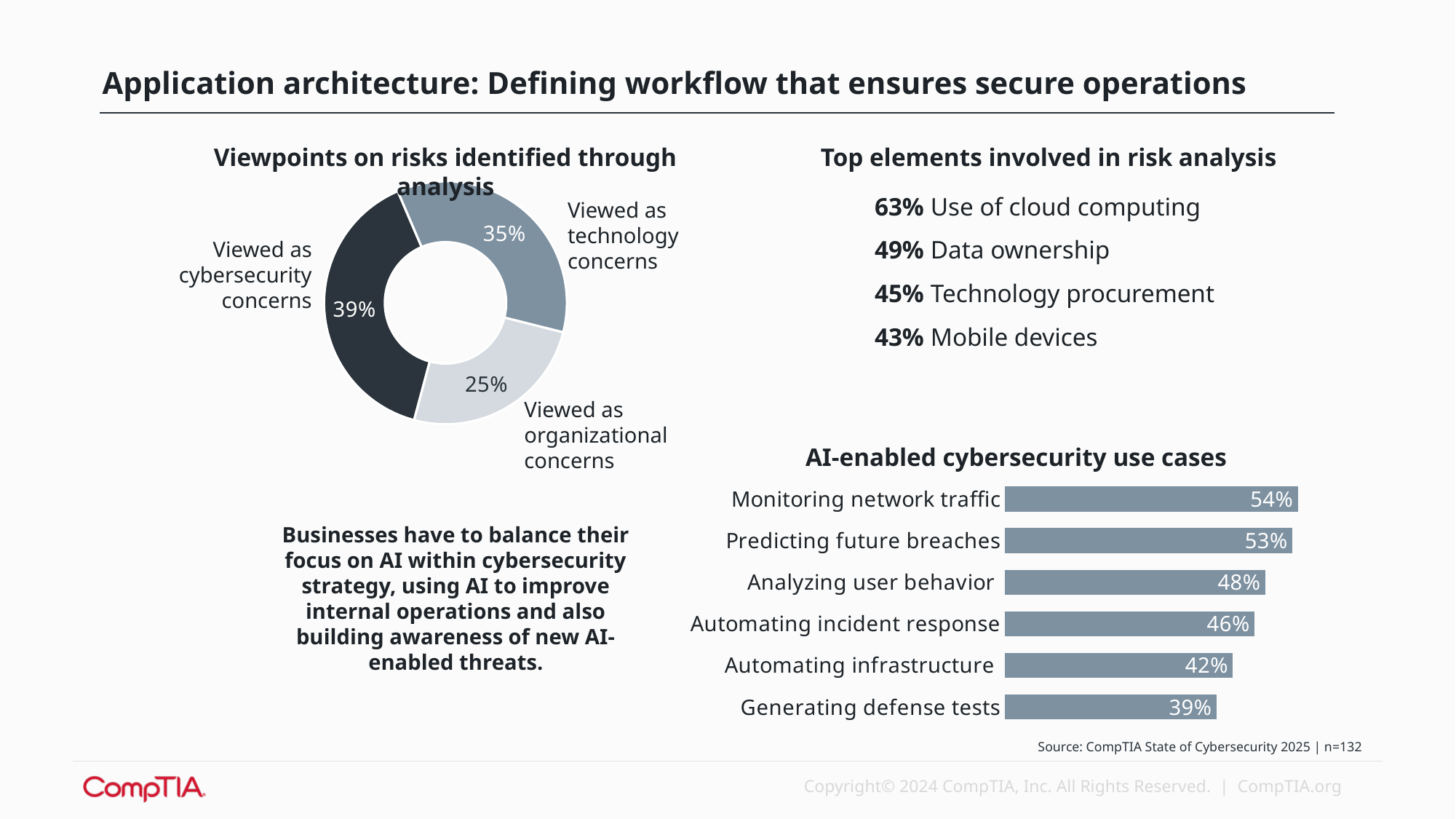
In the 'AI-enabled cybersecurity use cases' chart, which use case has the highest value? Monitoring network traffic In the 'Viewpoints on risks identified through analysis' chart, which viewpoint has the smallest share? Viewed as organizational concerns In the 'Viewpoints on risks identified through analysis' chart, how many slices are there? 3 What kind of chart is 'AI-enabled cybersecurity use cases'? Bar chart In the 'AI-enabled cybersecurity use cases' chart, how many use cases are shown? 6 In the 'Viewpoints on risks identified through analysis' chart, what percentage is viewed as cybersecurity concerns? 39% In the 'Viewpoints on risks identified through analysis' chart, which viewpoint has the largest share? Viewed as cybersecurity concerns In the 'Viewpoints on risks identified through analysis' chart, what percentage is viewed as organizational concerns? 25% In the 'AI-enabled cybersecurity use cases' chart, what is the difference between Monitoring network traffic and Generating defense tests? 15% What kind of chart is 'Viewpoints on risks identified through analysis'? Donut (pie) chart In the 'AI-enabled cybersecurity use cases' chart, which use case has the lowest value? Generating defense tests In the 'AI-enabled cybersecurity use cases' chart, what is the value for Analyzing user behavior? 48%